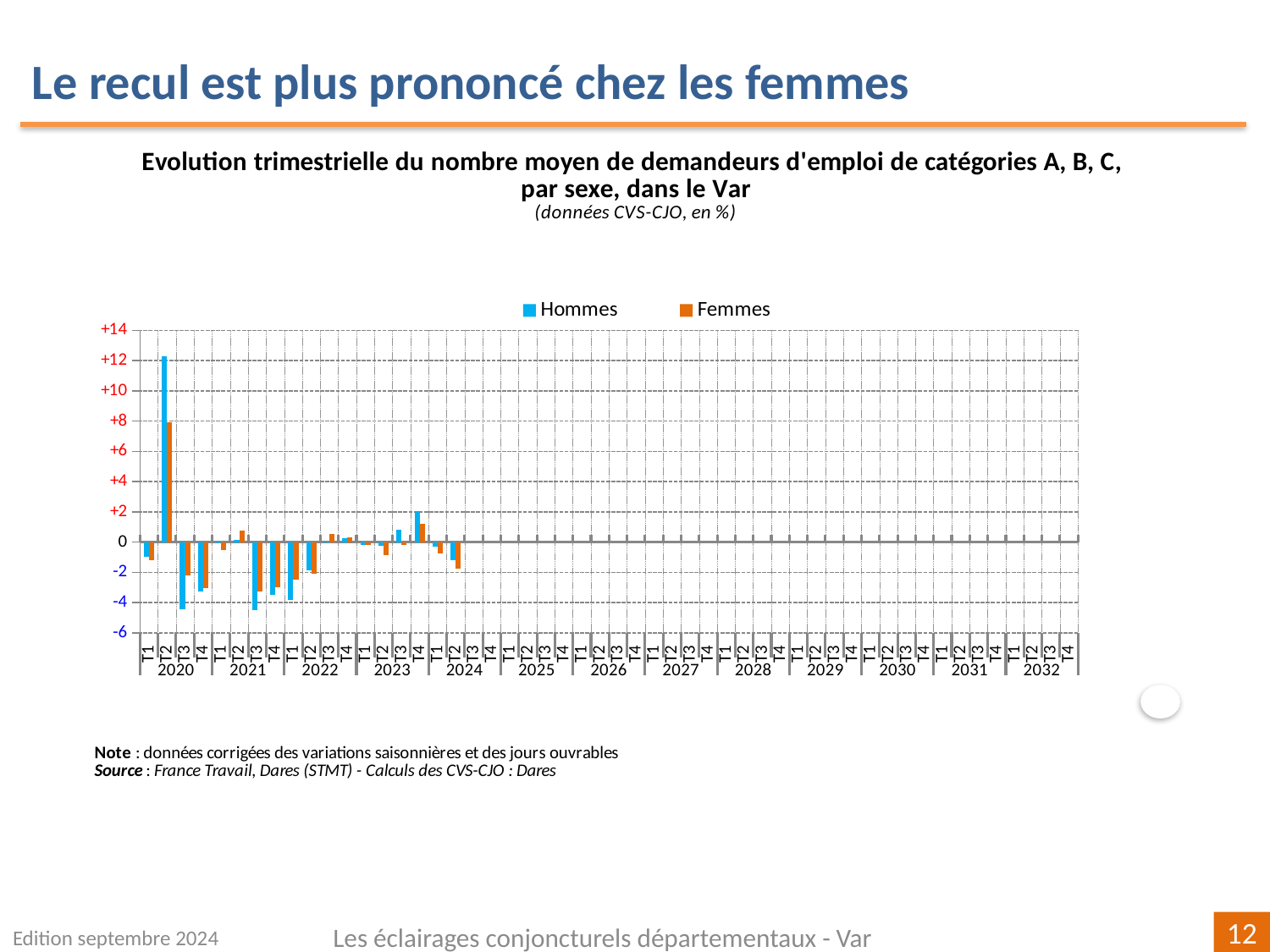
Is the Femmes value for T2 2020 greater or less than +6? greater How many series does the legend list? 2 In which quarter is the Hommes value the highest? T2 2020 In T4 2023, which series has the larger value, Hommes or Femmes? Hommes What kind of chart is shown on the slide? bar chart How many years are labelled along the x axis? 13 What are the two series named in the legend? Hommes and Femmes Is the Femmes value for T2 2024 greater or less than 0? less Is the Hommes value for T3 2020 greater or less than -2? less In T2 2020, which series has the larger value, Hommes or Femmes? Hommes What unit is stated in the chart subtitle? %